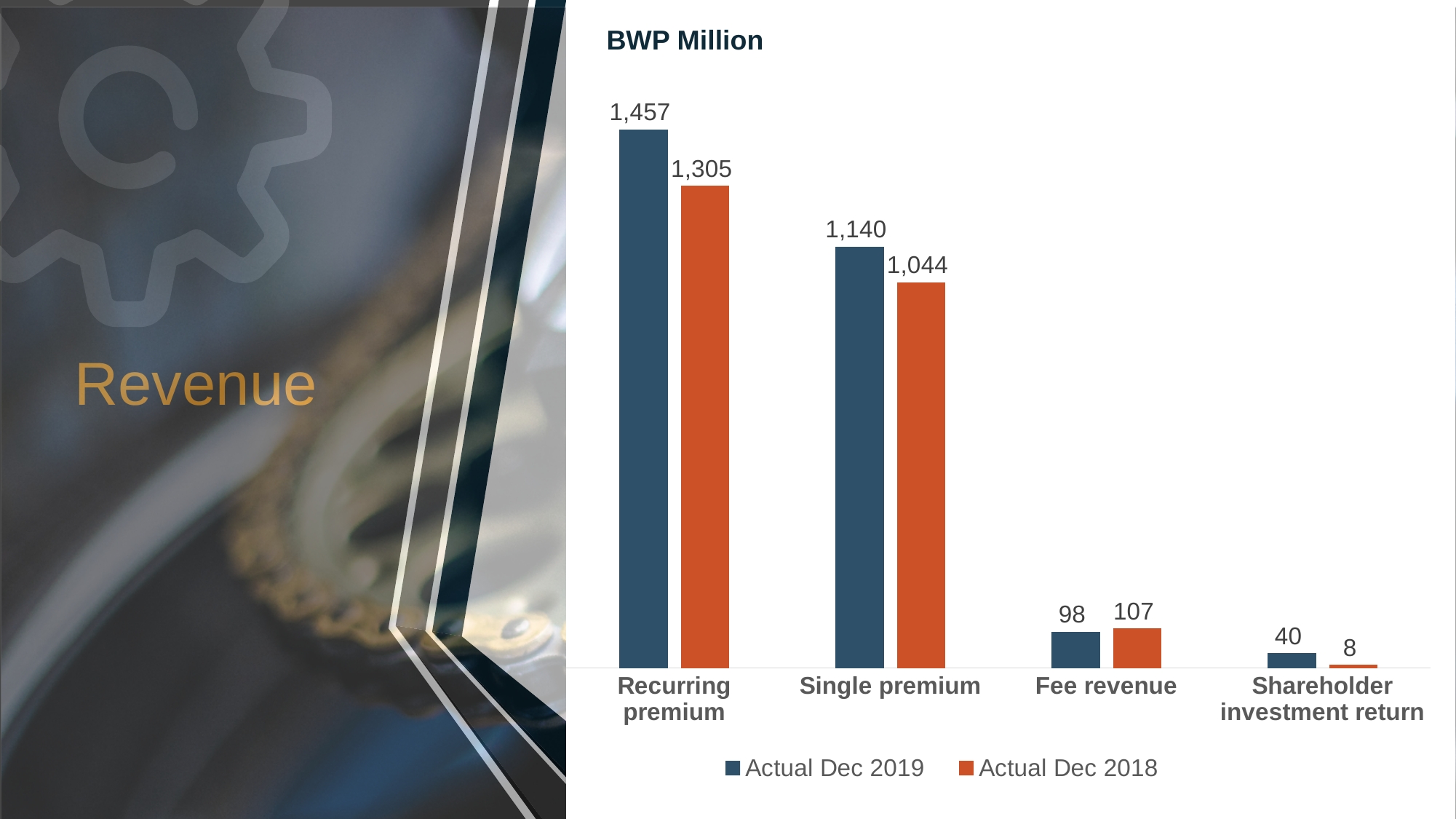
What kind of chart is shown on the slide? Bar chart Which category has the highest Actual Dec 2019 value? Recurring premium Which category has the lowest Actual Dec 2018 value? Shareholder investment return What unit is stated above the chart? BWP Million How many series does the legend list? 2 What is the Actual Dec 2019 value for Recurring premium? 1,457 For Fee revenue, which is larger: Actual Dec 2019 or Actual Dec 2018? Actual Dec 2018 What is the difference between the Actual Dec 2018 and Actual Dec 2019 values for Fee revenue? 9 How many categories are shown on the x axis? 4 What is the Actual Dec 2018 value for Shareholder investment return? 8 What is the difference between the Actual Dec 2019 and Actual Dec 2018 values for Recurring premium? 152 What is the Actual Dec 2018 value for Single premium? 1,044